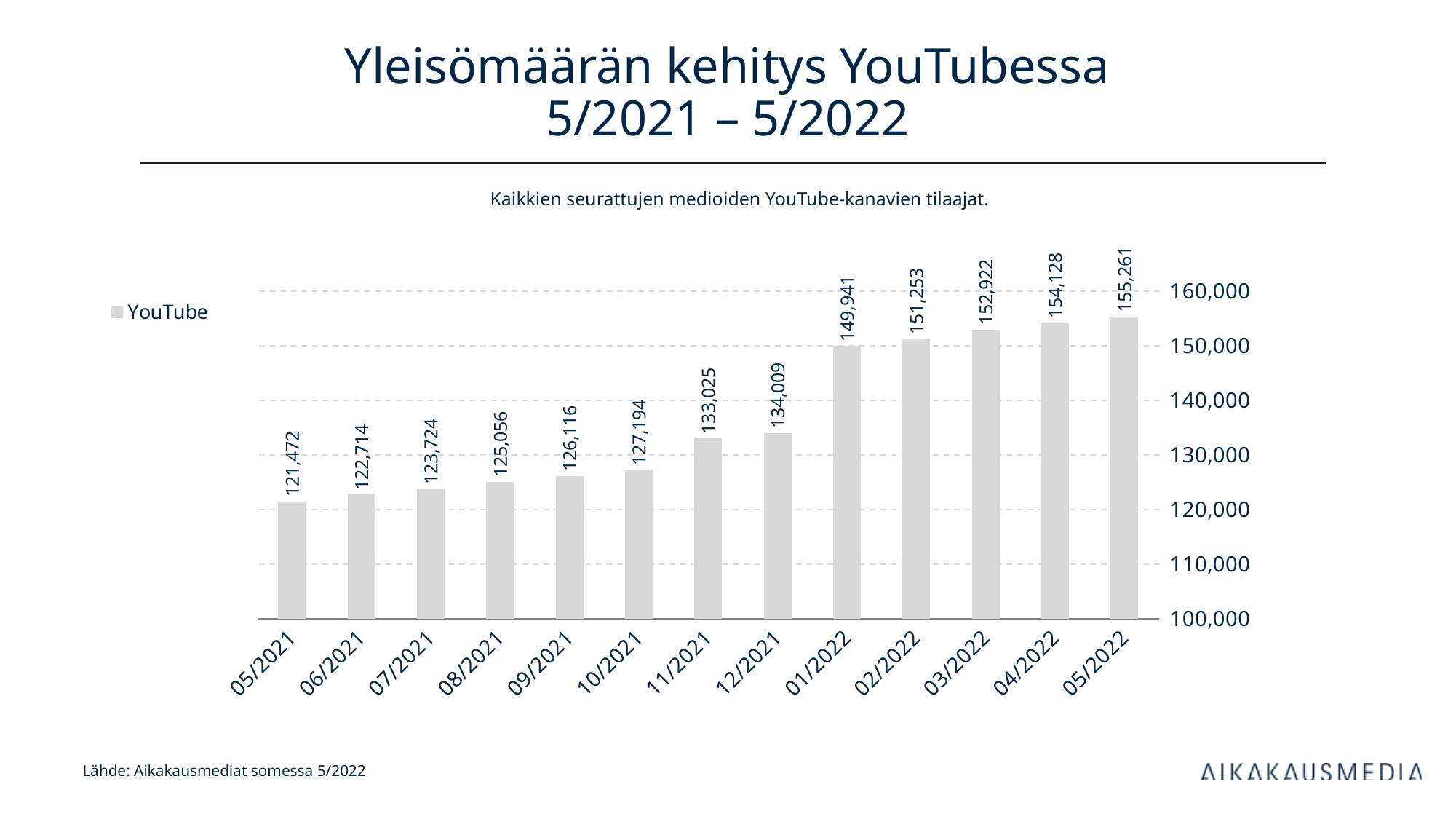
What kind of chart is shown on the slide? bar chart Is the value for 03/2022 greater or less than 150,000? greater What is the value for 05/2021? 121,472 How many months are shown on the x axis? 13 Do the values rise or fall from 05/2021 to 05/2022? rise What is the value for 01/2022? 149,941 Which month has the highest value? 05/2022 Which month has the lowest value? 05/2021 What is the difference between the values for 01/2022 and 12/2021? 15,932 Which is larger, the value for 10/2021 or the value for 08/2021? 10/2021 What is the value for 11/2021? 133,025 What is the difference between the values for 05/2022 and 05/2021? 33,789